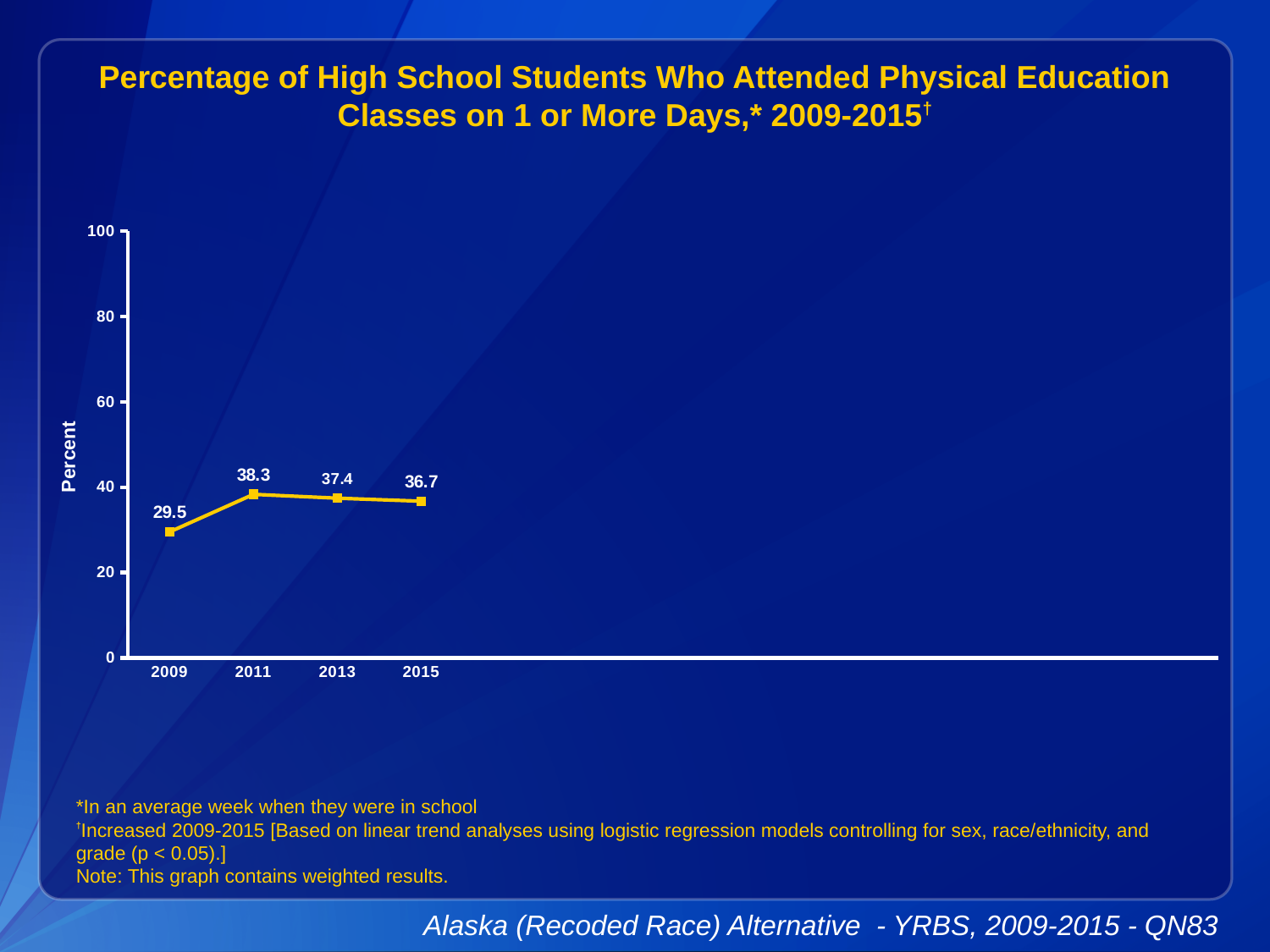
What kind of chart is shown on the slide? line chart What is the difference between the values for 2011 and 2009? 8.8 What is the value for 2011? 38.3 Which is larger, the value for 2013 or the value for 2015? 2013 How many years are plotted on the chart? 4 What is the value for 2015? 36.7 What is the value for 2013? 37.4 What is the label of the y axis? Percent Is the value for 2009 greater or less than 40? less Which year has the highest value? 2011 What is the value for 2009? 29.5 Which year has the lowest value? 2009